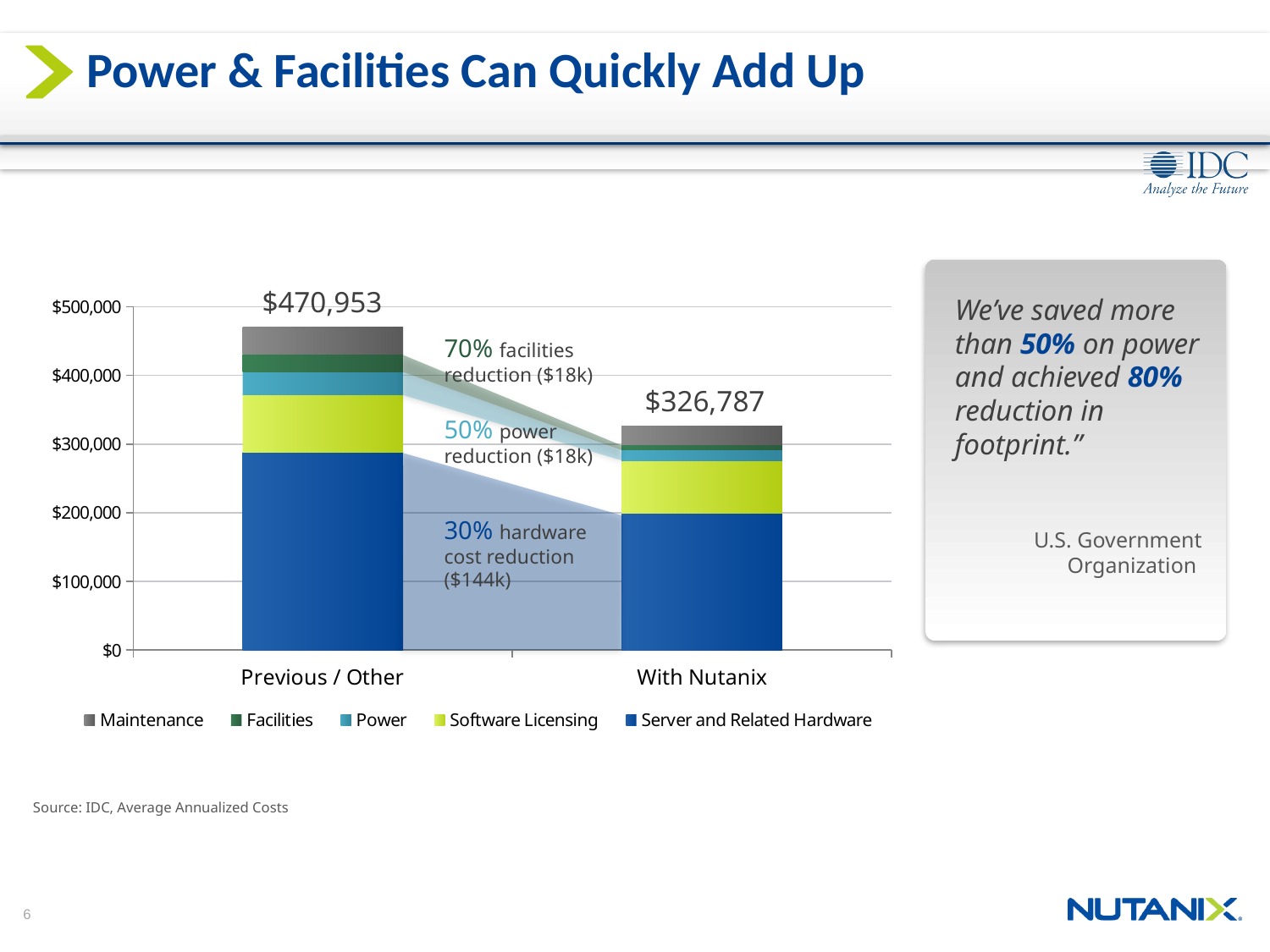
What is the total annualized cost shown for the With Nutanix bar? $326,787 Which category has the lowest total cost? With Nutanix Which bar has the higher total cost, Previous / Other or With Nutanix? Previous / Other Do the total costs rise or fall from Previous / Other to With Nutanix? fall What is the difference between the Previous / Other total and the With Nutanix total? $144,166 What is the total annualized cost shown for the Previous / Other bar? $470,953 What kind of chart is shown on the slide? Stacked bar chart Is the Server and Related Hardware value for Previous / Other greater or less than $200,000? greater According to the annotation on the chart, what percentage is the hardware cost reduction? 30% Which series is shown in dark blue at the bottom of each bar? Server and Related Hardware How many categories are shown on the x axis? 2 How many series does the legend list? 5